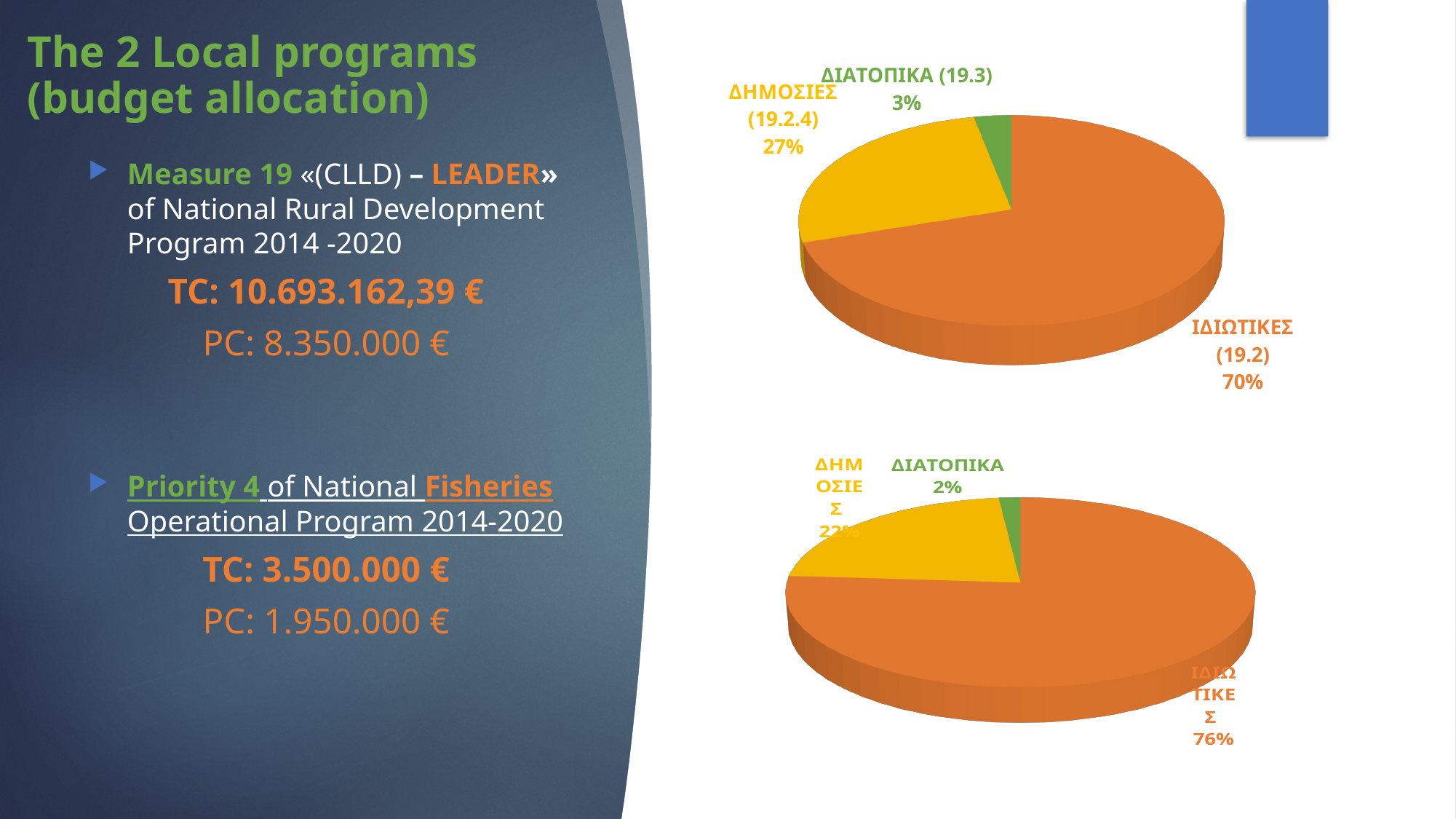
In the top pie chart, which slice is the largest? ΙΔΙΩΤΙΚΕΣ (19.2) In the top pie chart, what is the difference between the ΙΔΙΩΤΙΚΕΣ (19.2) share and the ΔΗΜΟΣΙΕΣ (19.2.4) share? 43% In the top pie chart, what share does ΔΗΜΟΣΙΕΣ (19.2.4) have? 27% In the top pie chart, how many slices are there? 3 In the top pie chart, which slice is the smallest? ΔΙΑΤΟΠΙΚΑ (19.3) Which is larger: the ΙΔΙΩΤΙΚΕΣ share in the top pie chart or the ΙΔΙΩΤΙΚΕΣ share in the bottom pie chart? bottom pie chart In the bottom pie chart, what share does ΔΙΑΤΟΠΙΚΑ have? 2% In the top pie chart, what share does ΔΙΑΤΟΠΙΚΑ (19.3) have? 3% What type of chart is the top chart on the slide? pie chart In the bottom pie chart, which slice is the smallest? ΔΙΑΤΟΠΙΚΑ